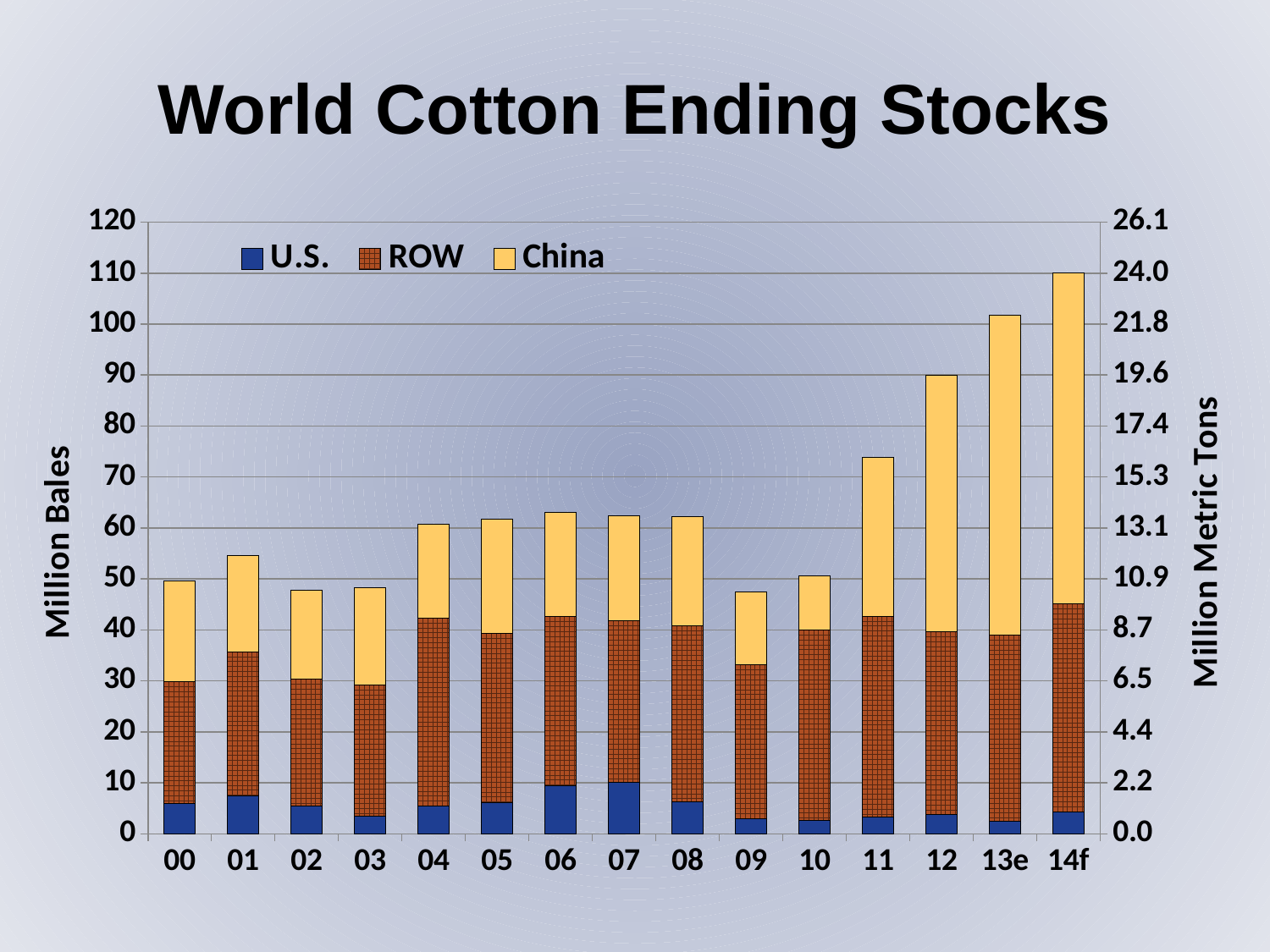
Which has the larger total ending stocks, 13e or 14f? 14f What kind of chart is shown on the slide? Stacked bar chart Do total ending stocks rise or fall from 11 to 14f? rise Which has the larger total ending stocks, 10 or 11? 11 How many years (categories) are shown along the x axis? 15 Is the total value for 11 greater or less than 70 million bales? greater Is the total value for 14f greater or less than 100 million bales? greater How many series does the legend list? 3 What is the label on the left vertical axis? Million Bales What is the title of the chart? World Cotton Ending Stocks Which year has the highest total ending stocks? 14f Is the total value for 01 greater or less than 50 million bales? greater